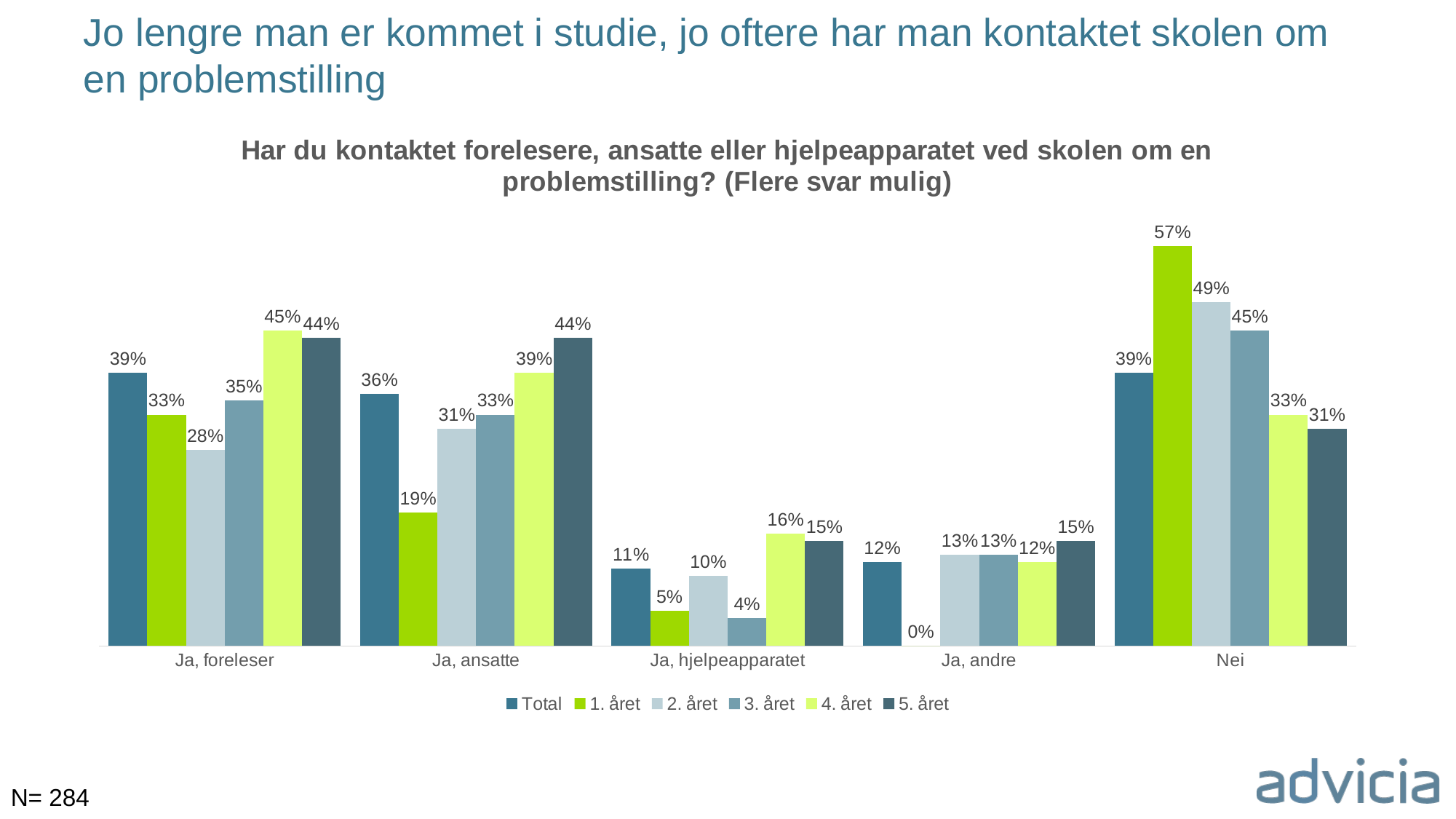
What is the Total value for Ja, ansatte? 36% How many series does the legend list? 6 Which series has the lowest value in the Ja, hjelpeapparatet category? 3. året What is the value for 1. året in the Ja, andre category? 0% What is the difference between the 5. året and 1. året values for Ja, ansatte? 25 percentage points What is the value for 2. året in the Ja, foreleser category? 28% What kind of chart is shown on the slide? Bar chart How many categories are shown on the x axis? 5 What is the value for 1. året in the Nei category? 57% Which is larger for Ja, foreleser: the 4. året value or the 3. året value? 4. året What is the sample size (N) stated on the slide? 284 Which series has the highest value in the Nei category? 1. året